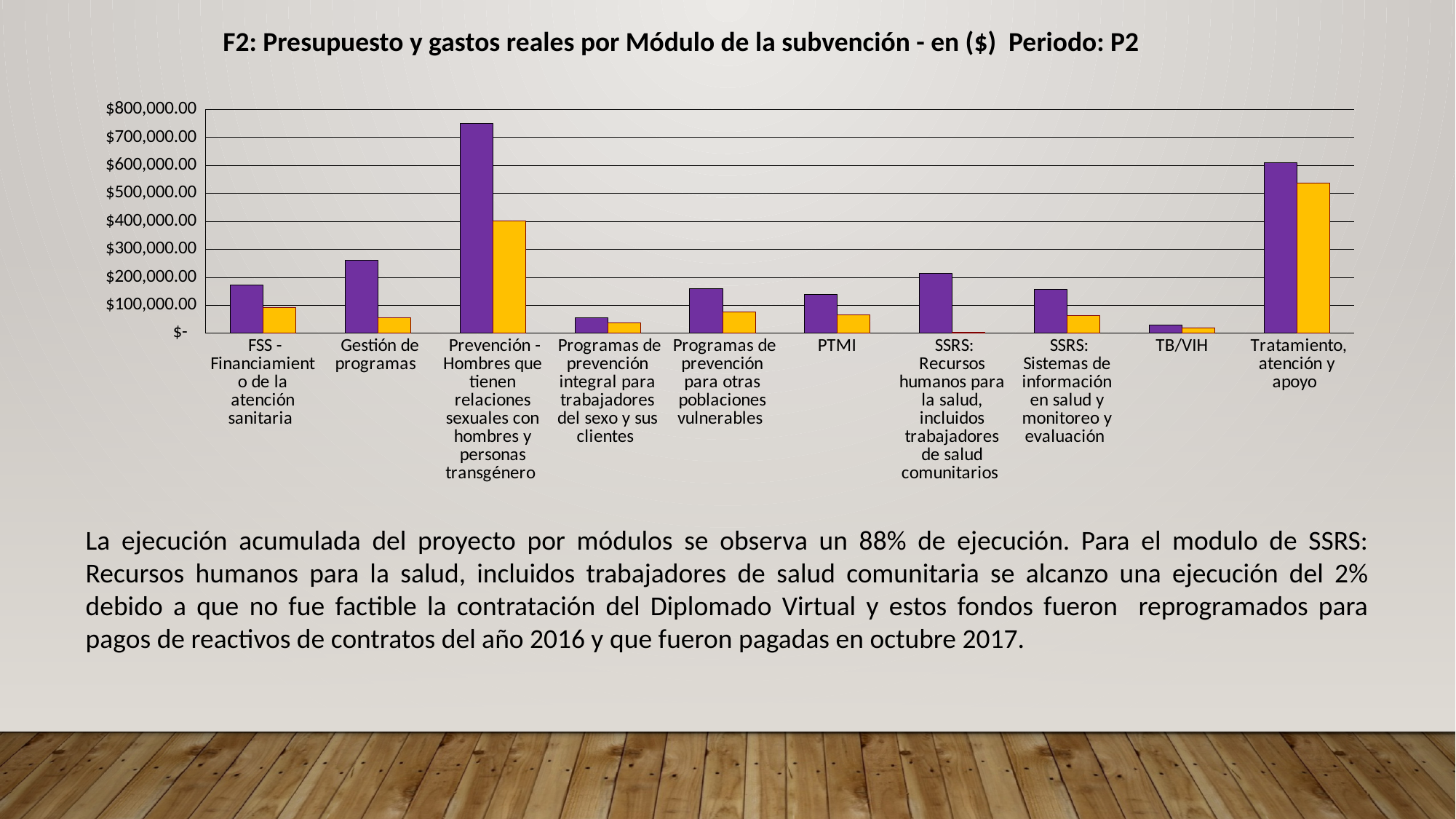
How many bars are plotted for each category in the chart? 2 What kind of chart is shown on the slide? bar chart Which category has the tallest purple bar? Prevención - Hombres que tienen relaciones sexuales con hombres y personas transgénero What is the title of the chart? F2: Presupuesto y gastos reales por Módulo de la subvención - en ($) Periodo: P2 How many module categories are shown on the x axis of the chart? 10 Is the yellow bar for 'SSRS: Recursos humanos para la salud, incluidos trabajadores de salud comunitarios' greater or less than $100,000.00? less Which category has the taller purple bar, 'Gestión de programas' or 'PTMI'? Gestión de programas Which category has the shortest purple bar? TB/VIH Is the purple bar for 'FSS - Financiamiento de la atención sanitaria' greater or less than $200,000.00? less For 'Prevención - Hombres que tienen relaciones sexuales con hombres y personas transgénero', which bar is taller, the purple one or the yellow one? purple Is the purple bar for 'Tratamiento, atención y apoyo' greater or less than $500,000.00? greater